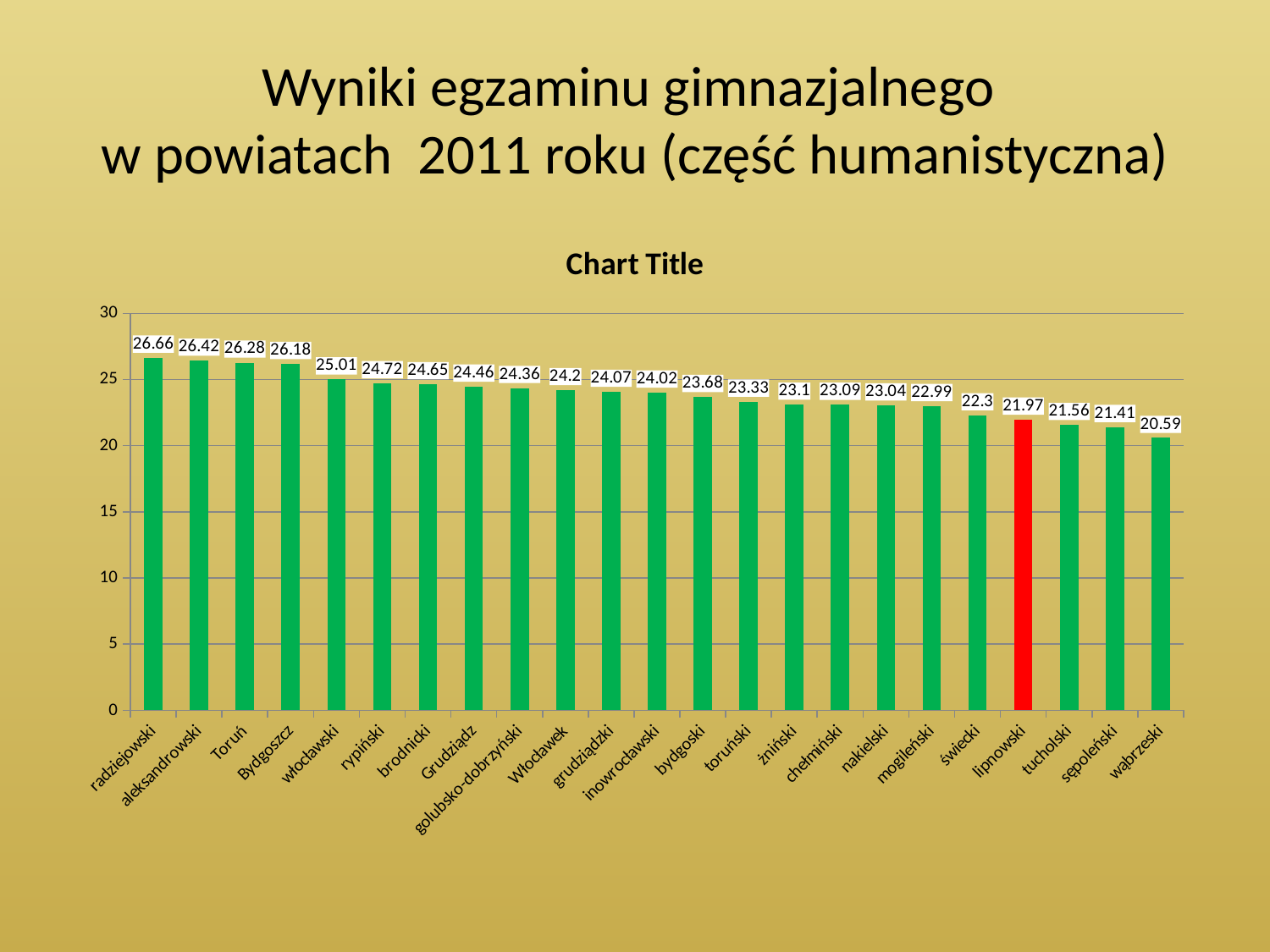
Which category has the highest value? radziejowski What is the value for golubsko-dobrzyński? 24.36 What kind of chart is shown on the slide? bar chart Which category's bar is coloured red instead of green? lipnowski What is the value for lipnowski? 21.97 What is the difference between the values for Toruń and Bydgoszcz? 0.1 Which is larger, the value for włocławski or the value for świecki? włocławski How many categories are shown on the x axis? 23 Is the value for tucholski greater or less than 25? less Which category has the lowest value? wąbrzeski What is the value for radziejowski? 26.66 What is the difference between the values for radziejowski and wąbrzeski? 6.07